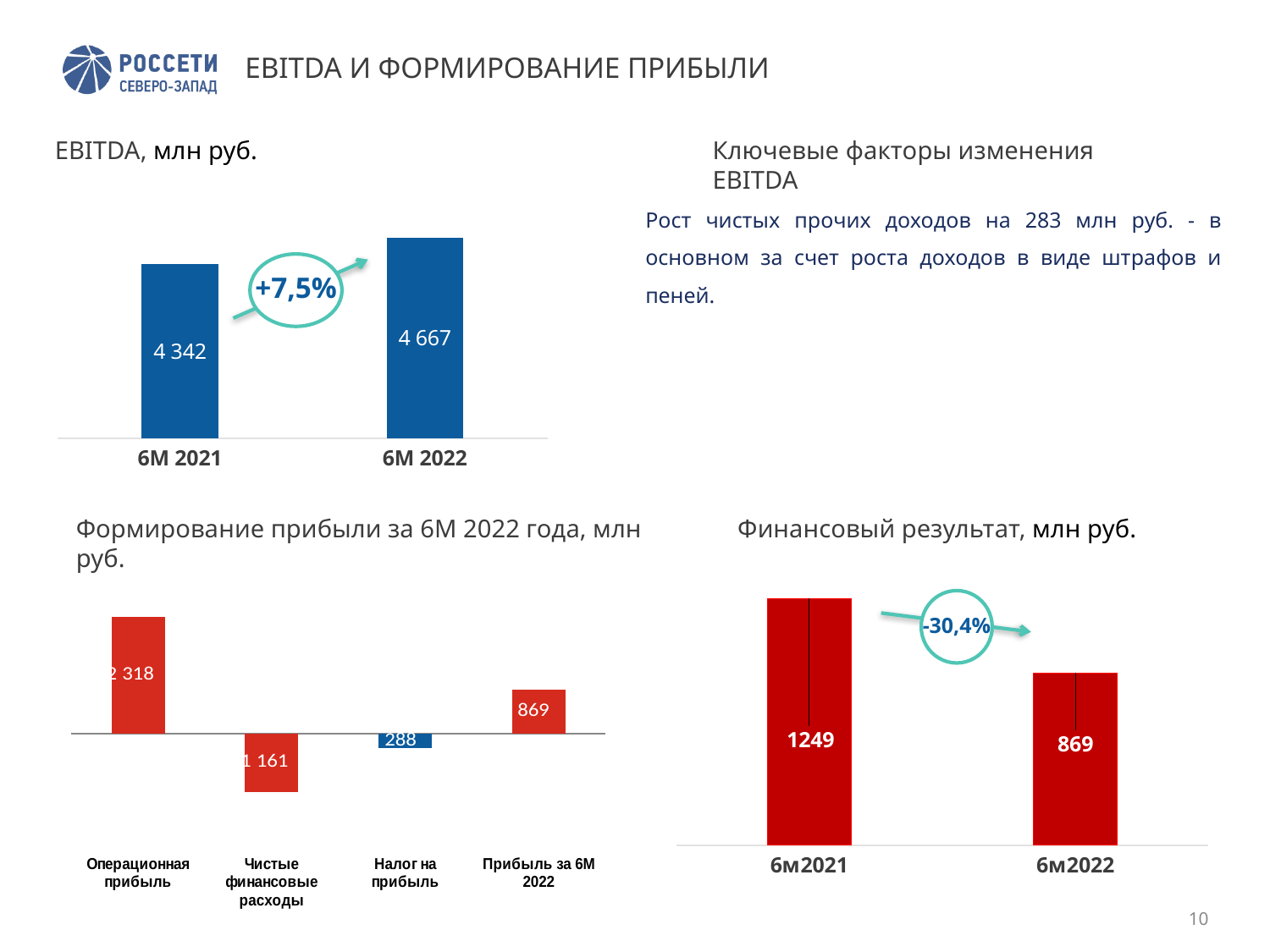
In the Формирование прибыли за 6М 2022 года chart, what is the value for Прибыль за 6М 2022? 869 In the EBITDA chart, which period has the higher value? 6M 2022 In the EBITDA chart, what percentage change is shown between 6M 2021 and 6M 2022? +7,5% In the Финансовый результат chart, what is the difference between the 6м2021 and 6м2022 values? 380 In the EBITDA chart, what is the difference between the 6M 2022 and 6M 2021 values? 325 In the Финансовый результат chart, which period has the lower value? 6м2022 In the EBITDA chart, what is the value for 6M 2022? 4 667 How many categories are shown in the Формирование прибыли за 6М 2022 года chart? 4 In the Финансовый результат chart, do the values rise or fall from 6м2021 to 6м2022? fall In the Финансовый результат chart, what is the value for 6м2021? 1249 In the EBITDA chart, what is the value for 6M 2021? 4 342 In the Финансовый результат chart, what is the value for 6м2022? 869